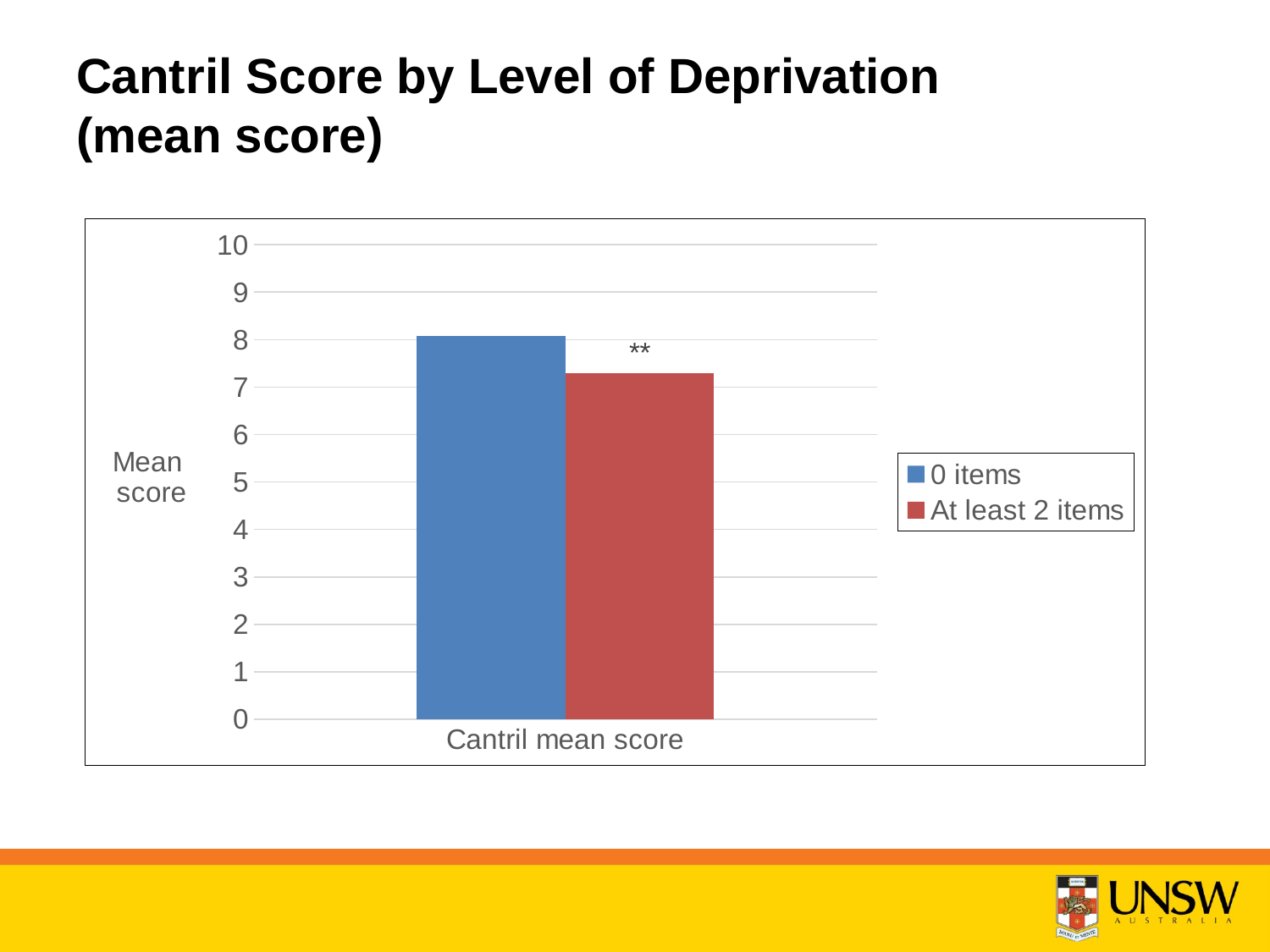
Is the Cantril mean score for 0 items greater or less than 7? greater What is the maximum value shown on the y axis? 10 Is the Cantril mean score for 0 items greater or less than 9? less How many series does the legend list? 2 Which series has the higher Cantril mean score, 0 items or At least 2 items? 0 items Is the Cantril mean score for At least 2 items greater or less than 8? less What is the title of the y axis? Mean score What is the label of the category on the x axis? Cantril mean score What kind of chart is shown on the slide? bar chart How many categories are shown on the x axis? 1 Which series has the lowest Cantril mean score? At least 2 items